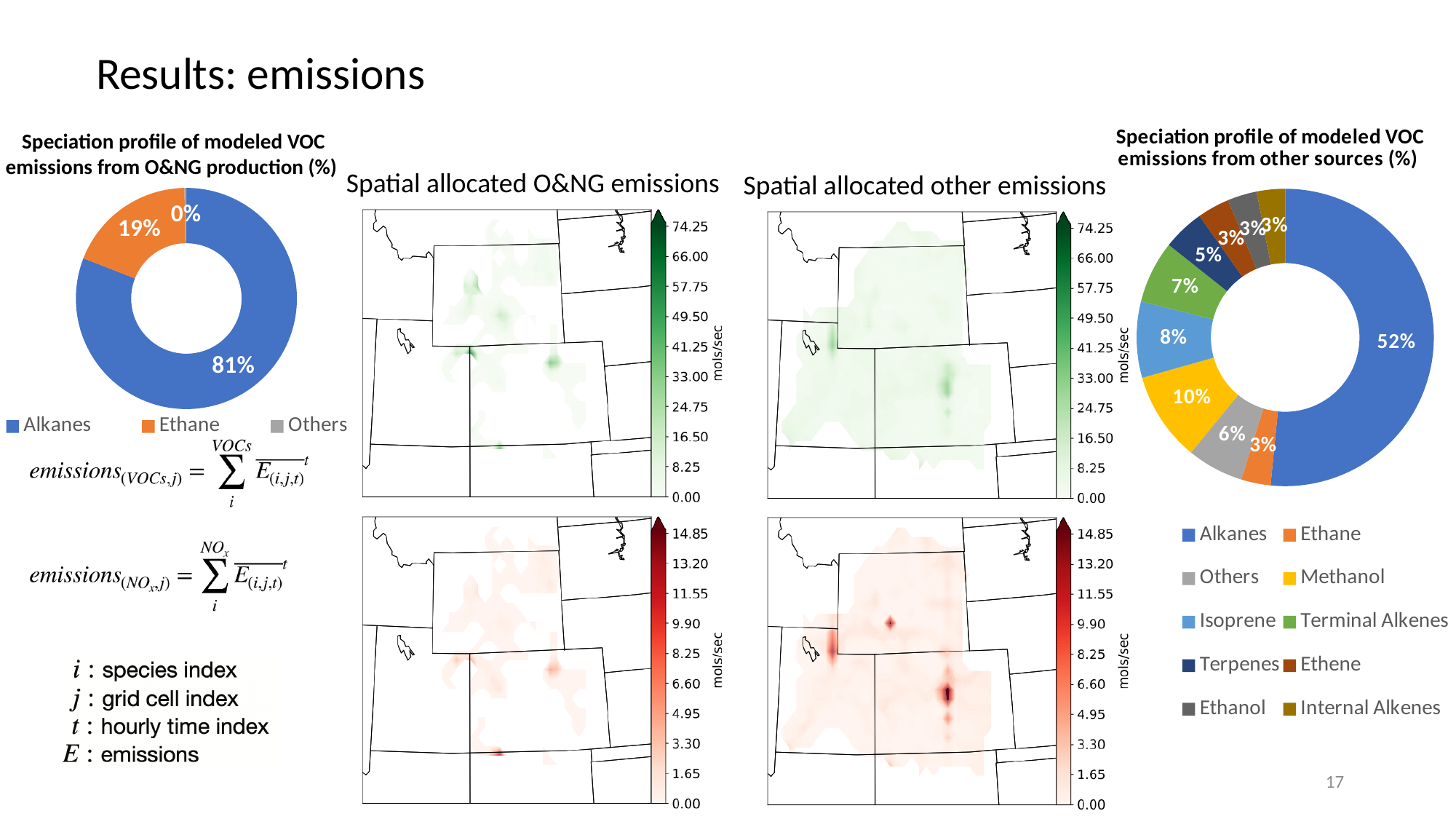
In the chart titled 'Speciation profile of modeled VOC emissions from other sources (%)', what share is labeled for Isoprene? 8% In the chart titled 'Speciation profile of modeled VOC emissions from O&NG production (%)', which category has the largest share? Alkanes In the chart titled 'Speciation profile of modeled VOC emissions from O&NG production (%)', how many categories does the legend list? 3 In the chart titled 'Speciation profile of modeled VOC emissions from other sources (%)', what share is labeled for Methanol? 10% In the chart titled 'Speciation profile of modeled VOC emissions from O&NG production (%)', what is the difference in percentage points between Alkanes and Ethane? 62 What kind of chart is the 'Speciation profile of modeled VOC emissions from other sources (%)' chart? Doughnut (pie) chart In the chart titled 'Speciation profile of modeled VOC emissions from other sources (%)', what share is labeled for Alkanes? 52% In the chart titled 'Speciation profile of modeled VOC emissions from other sources (%)', which is larger, the share for Terminal Alkenes or the share for Terpenes? Terminal Alkenes In the chart titled 'Speciation profile of modeled VOC emissions from other sources (%)', what colour is the Methanol slice? Yellow In the chart titled 'Speciation profile of modeled VOC emissions from other sources (%)', how many categories does the legend list? 10 In the chart titled 'Speciation profile of modeled VOC emissions from O&NG production (%)', what share is labeled for Alkanes? 81% In the chart titled 'Speciation profile of modeled VOC emissions from O&NG production (%)', what share is labeled for Ethane? 19%